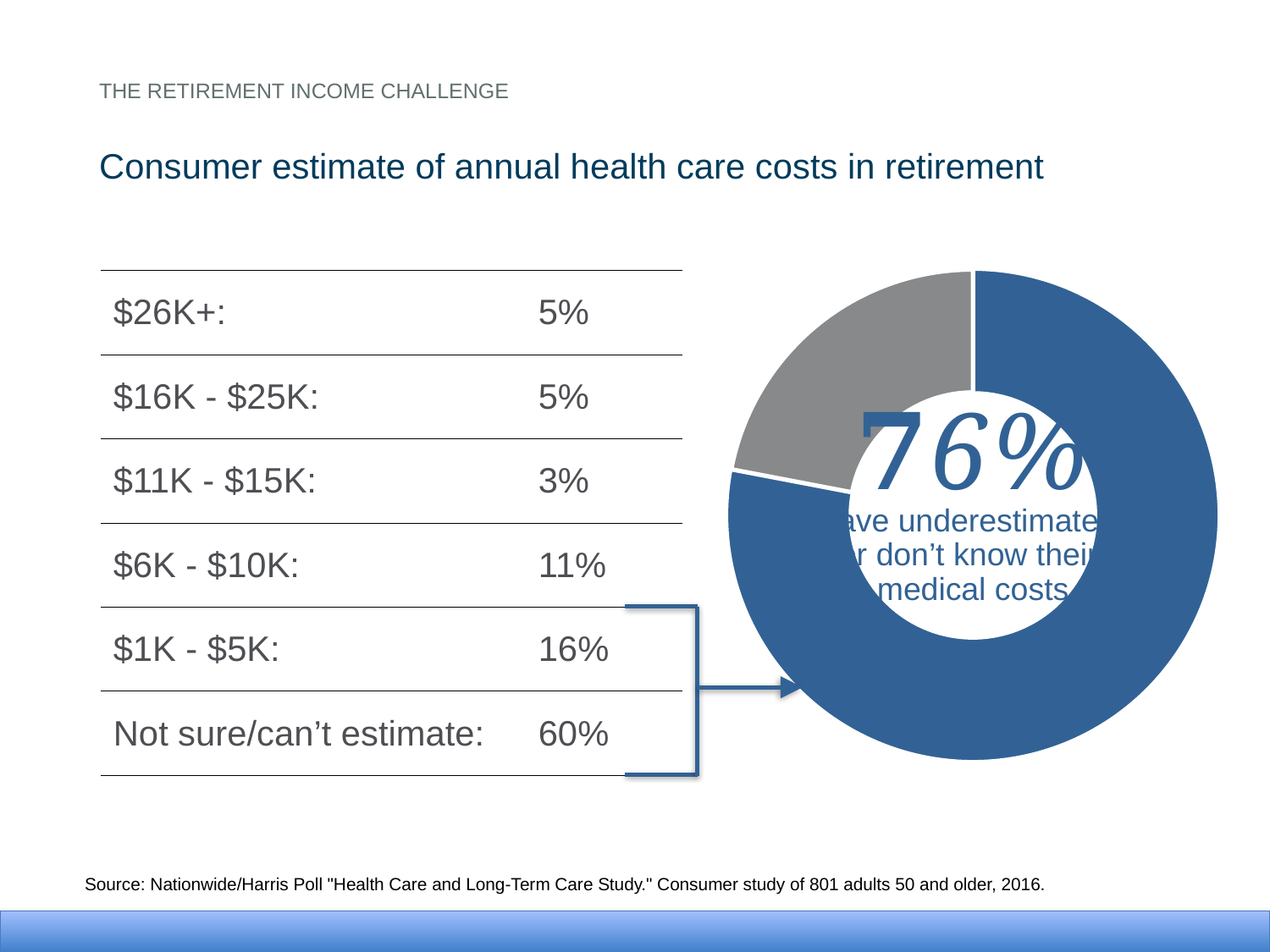
Which slice of the donut chart is larger, the blue one or the grey one? blue How many categories are listed in the table on the left? 6 In the table on the left, what percentage of consumers answered "Not sure/can't estimate"? 60% In the table on the left, which category has the highest percentage? Not sure/can't estimate What kind of chart is shown on the right of the slide? pie chart (donut) In the table on the left, what is the difference between the percentages for $1K - $5K and $6K - $10K? 5% Is the blue slice of the donut chart greater or less than 50% of the whole? greater In the table on the left, which category has the lowest percentage? $11K - $15K Is the grey slice of the donut chart greater or less than 50% of the whole? less How many slices does the donut chart have? 2 What percentage is printed in the centre of the donut chart? 76%